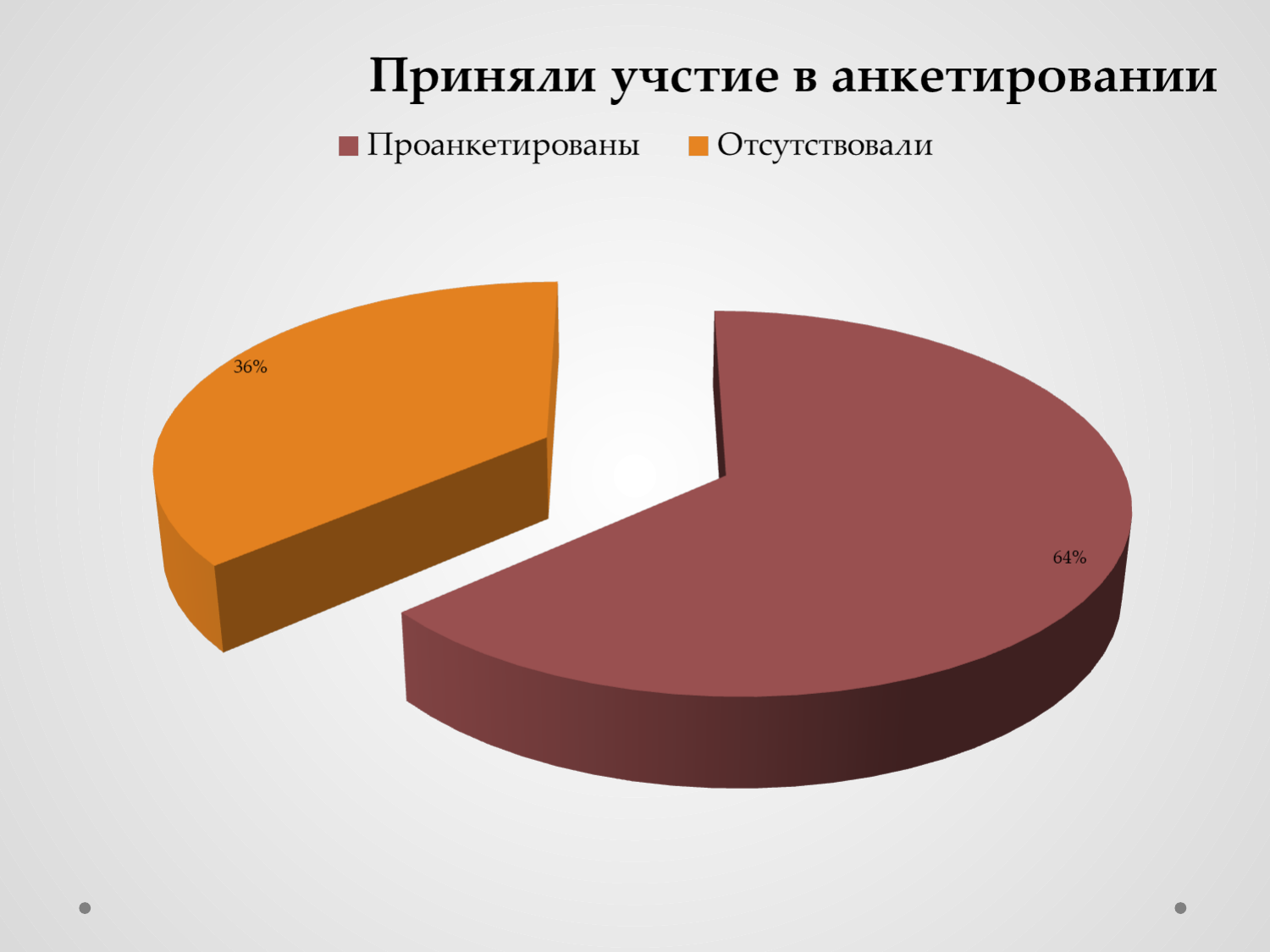
Which category has the smallest slice of the pie? Отсутствовали What kind of chart is shown on the slide? pie chart What is the difference in percentage points between the 'Проанкетированы' and 'Отсутствовали' slices? 28 How many slices does the pie chart have? 2 What share of the pie does the 'Проанкетированы' slice represent? 64% How many entries does the legend list? 2 Which is larger: the 'Проанкетированы' slice or the 'Отсутствовали' slice? Проанкетированы What is the title of the chart? Приняли учстие в анкетировании Which category has the largest slice of the pie? Проанкетированы What colour is the 'Отсутствовали' slice? orange What share of the pie does the 'Отсутствовали' slice represent? 36%